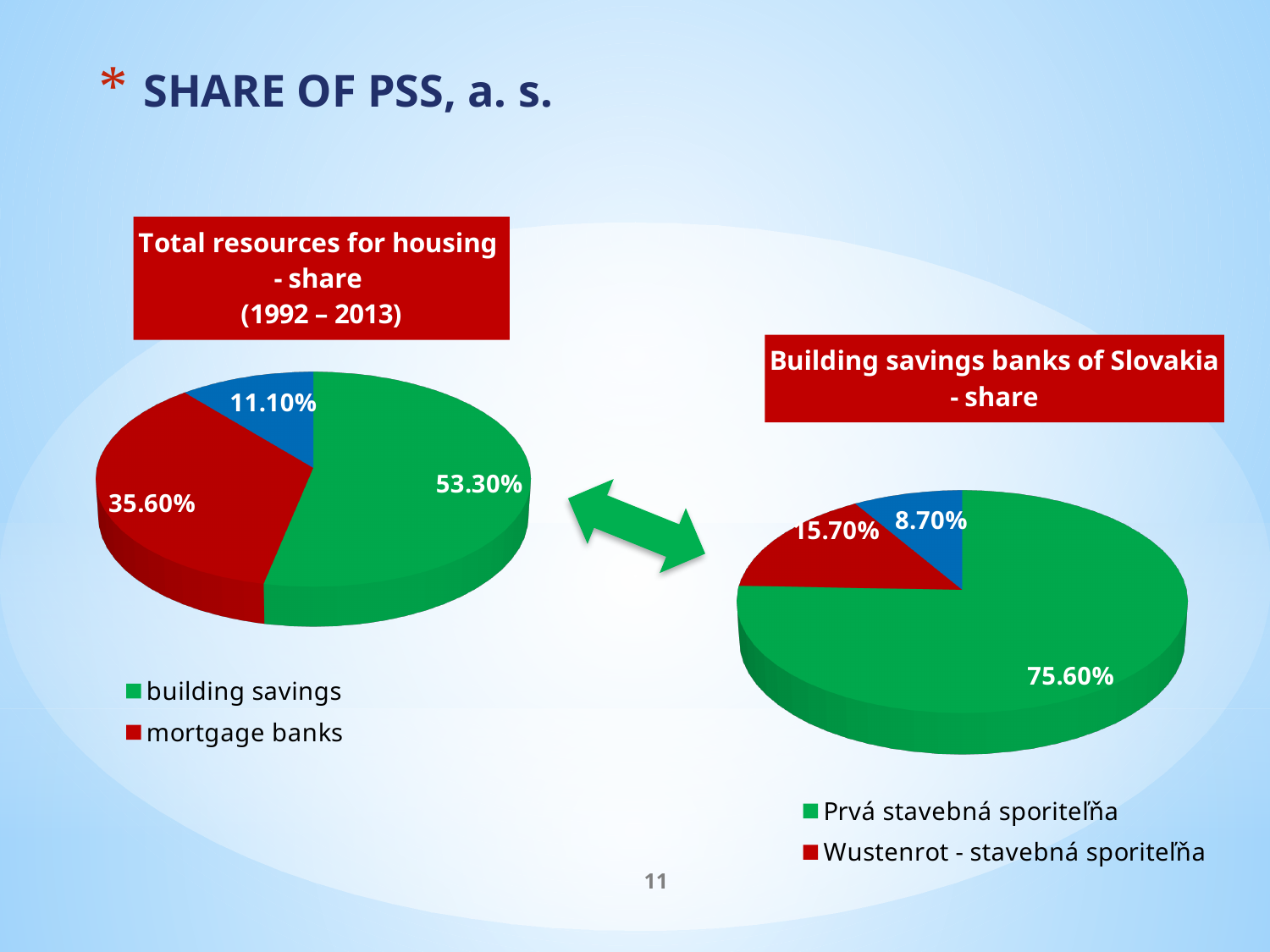
In the 'Total resources for housing - share (1992 – 2013)' pie chart, which legend category has the largest slice? building savings In the 'Total resources for housing - share (1992 – 2013)' pie chart, what is the share for building savings? 53.30% How many entries does the legend of the 'Building savings banks of Slovakia - share' chart list? 2 In the 'Building savings banks of Slovakia - share' pie chart, which legend category has the largest slice? Prvá stavebná sporiteľňa In the 'Total resources for housing - share (1992 – 2013)' pie chart, what is the share for mortgage banks? 35.60% In the 'Building savings banks of Slovakia - share' pie chart, what is the difference between the Prvá stavebná sporiteľňa share and the Wustenrot - stavebná sporiteľňa share? 59.90% How many slices does the 'Building savings banks of Slovakia - share' pie chart have? 3 In the 'Building savings banks of Slovakia - share' pie chart, what is the share for Prvá stavebná sporiteľňa? 75.60% In the 'Total resources for housing - share (1992 – 2013)' pie chart, what is the difference between the building savings share and the mortgage banks share? 17.70% What type of chart is used for 'Total resources for housing - share (1992 – 2013)'? pie chart In the 'Building savings banks of Slovakia - share' pie chart, what is the share for Wustenrot - stavebná sporiteľňa? 15.70% In the 'Total resources for housing - share (1992 – 2013)' pie chart, which is larger: building savings or mortgage banks? building savings